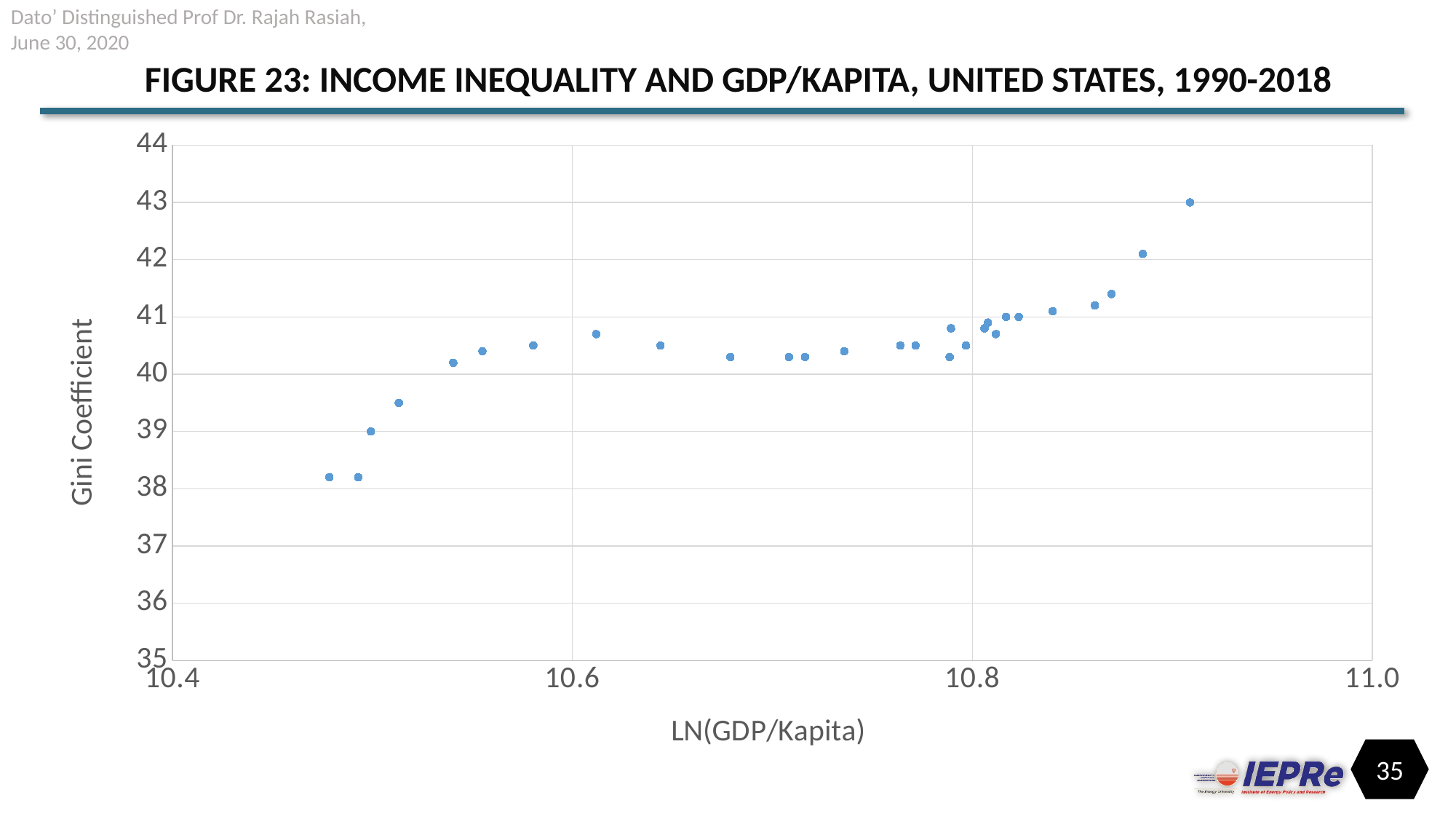
Are all plotted Gini coefficients greater or less than 44? less What kind of chart is shown on the slide? scatter plot Is the lowest Gini coefficient plotted greater or less than 38? greater Is the highest Gini coefficient plotted greater or less than 42? greater What is the label of the vertical axis? Gini Coefficient What is the title of the chart? FIGURE 23: INCOME INEQUALITY AND GDP/KAPITA, UNITED STATES, 1990-2018 Which has the higher Gini coefficient: the point with the highest LN(GDP/Kapita) or the point with the lowest LN(GDP/Kapita)? the point with the highest LN(GDP/Kapita) Overall, does the Gini coefficient rise or fall as LN(GDP/Kapita) increases? rise